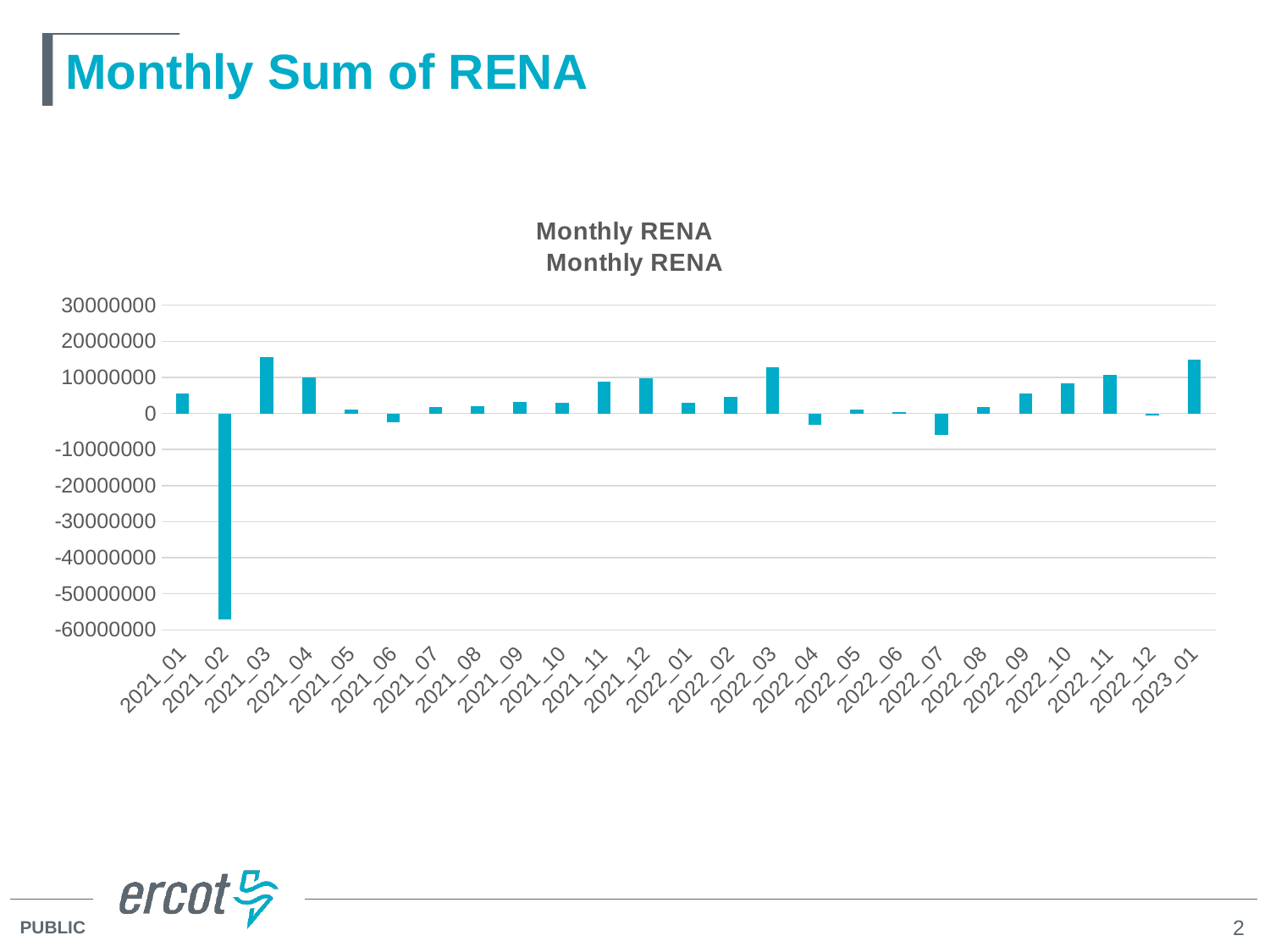
Is the value for 2021_03 greater or less than 10000000? greater Which is larger, the value for 2022_03 or the value for 2022_07? 2022_03 Is the value for 2022_03 greater or less than 10000000? greater What kind of chart is shown on the slide? bar chart Is the value for 2021_02 greater or less than -50000000? less What is the title shown above the chart? Monthly RENA Which month has the lowest value? 2021_02 Which is larger, the value for 2021_03 or the value for 2021_01? 2021_03 Which is larger, the value for 2021_11 or the value for 2021_05? 2021_11 How many monthly categories are plotted on the x axis? 25